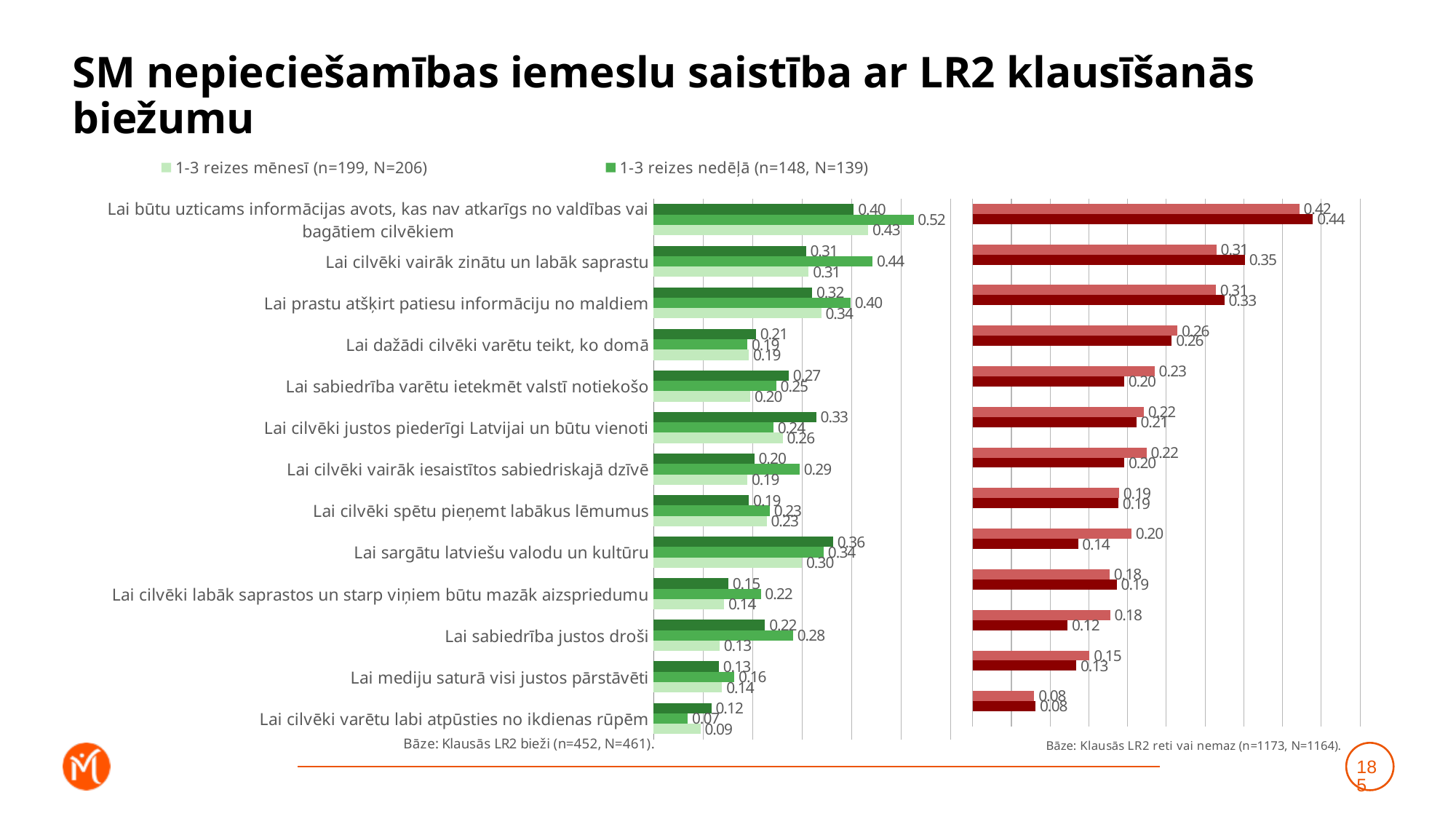
In the left (green) chart, which category has the highest value for '1-3 reizes nedēļā'? Lai būtu uzticams informācijas avots, kas nav atkarīgs no valdības vai bagātiem cilvēkiem How many series does the legend above the left (green) chart list? 2 In the left (green) chart, how much higher is the '1-3 reizes nedēļā' value than the '1-3 reizes mēnesī' value for 'Lai cilvēki vairāk zinātu un labāk saprastu'? 0.13 How many categories are listed on the left (green) chart? 13 What type of chart is used on this slide? Bar chart In the right (red) chart, what is the value of the bottom dark red bar for 'Lai sargātu latviešu valodu un kultūru'? 0.14 What base note is printed under the left (green) chart? Bāze: Klausās LR2 bieži (n=452, N=461). In the right (red) chart, which category has the highest value for the top (lighter red) bar? Lai būtu uzticams informācijas avots, kas nav atkarīgs no valdības vai bagātiem cilvēkiem In the left (green) chart, which category has the lowest value for '1-3 reizes nedēļā'? Lai cilvēki varētu labi atpūsties no ikdienas rūpēm In the left (green) chart, what is the value for '1-3 reizes mēnesī' for 'Lai sabiedrība justos droši'? 0.13 In the left (green) chart, which has the larger '1-3 reizes mēnesī' value: 'Lai sargātu latviešu valodu un kultūru' or 'Lai cilvēki spētu pieņemt labākus lēmumus'? Lai sargātu latviešu valodu un kultūru In the left (green) chart, what is the value for '1-3 reizes nedēļā' for 'Lai būtu uzticams informācijas avots, kas nav atkarīgs no valdības vai bagātiem cilvēkiem'? 0.52